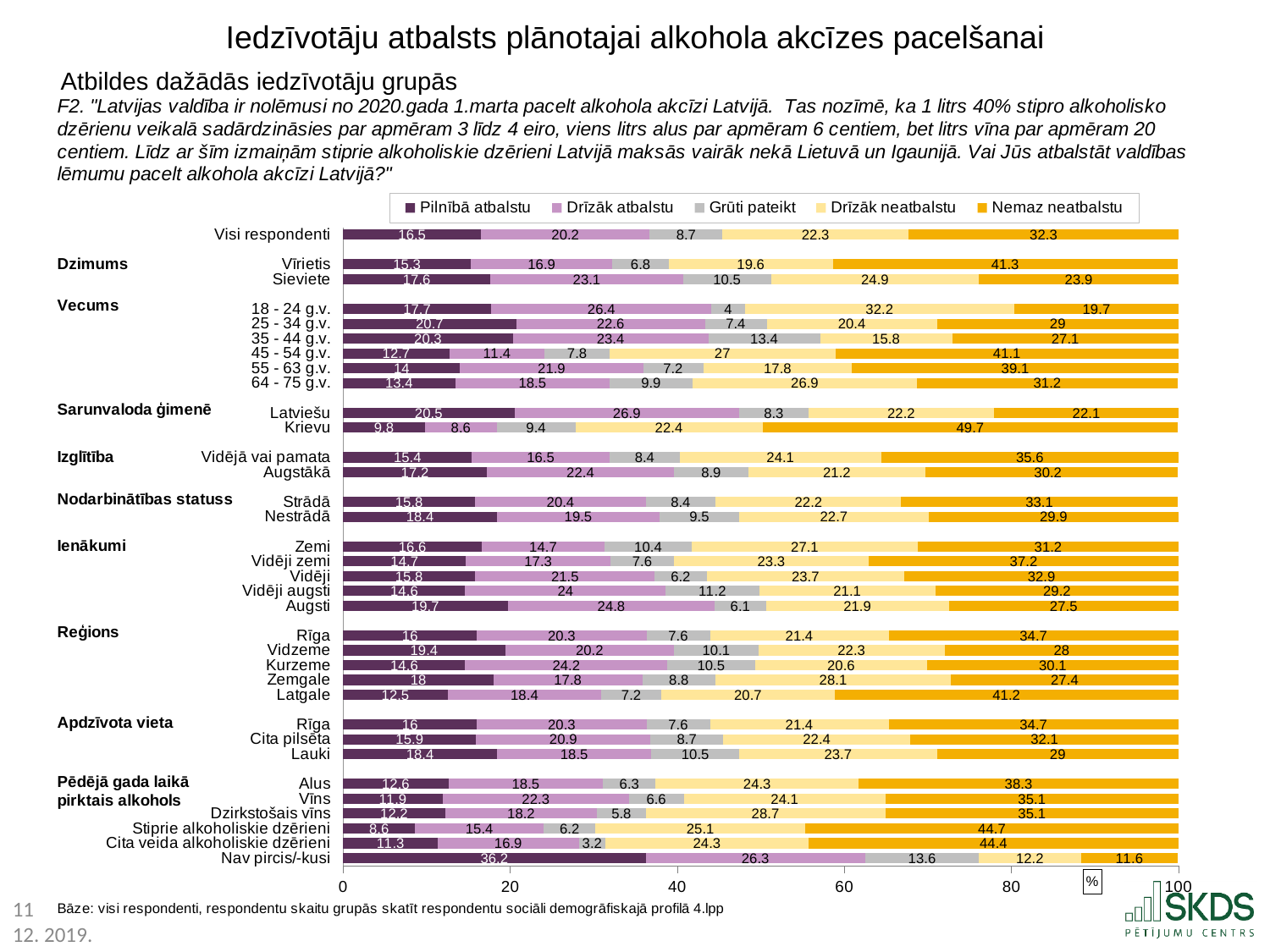
What is the 'Drīzāk atbalstu' value for the Latviešu group? 26.9 Among the Reģions groups, which has the lowest 'Pilnībā atbalstu' value? Latgale What is the 'Nemaz neatbalstu' value for the Krievu group? 49.7 How many series does the legend list? 5 What percentage of all respondents (Visi respondenti) answered 'Nemaz neatbalstu'? 32.3 Which has the larger 'Nemaz neatbalstu' value, Vīrietis or Sieviete? Vīrietis What is the first entry in the chart legend? Pilnībā atbalstu What is the 'Pilnībā atbalstu' value for the 'Nav pircis/-kusi' group? 36.2 What is the 'Nemaz neatbalstu' value for 'Stiprie alkoholiskie dzērieni'? 44.7 What kind of chart is shown on the slide? Stacked bar chart Among the Vecums (age) groups, which has the highest 'Nemaz neatbalstu' value? 45 - 54 g.v. For all respondents (Visi respondenti), what is the difference between the 'Drīzāk neatbalstu' and 'Pilnībā atbalstu' values? 5.8